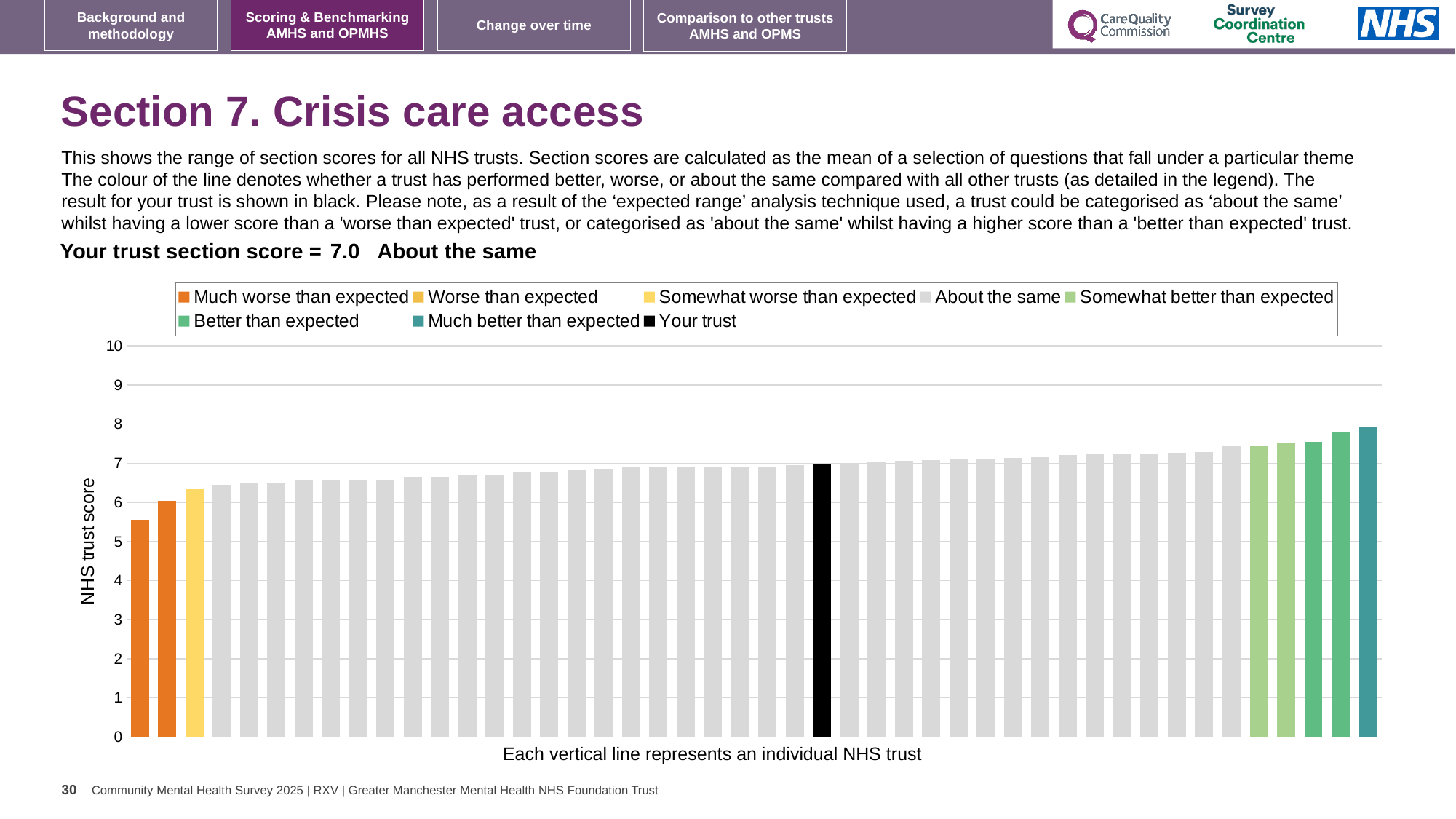
Is the value of the tallest bar greater or less than 7? greater Which legend category does the tallest bar belong to? Much better than expected Which category is your trust placed in for this section? About the same How many entries does the chart legend list? 8 Which legend category does the shortest bar belong to? Much worse than expected What is the label on the vertical axis of the chart? NHS trust score Is the value of the black 'Your trust' bar greater or less than 6? greater What is the section score for your trust, as stated on the slide? 7.0 Do the bar values rise or fall from left to right along the x axis? rise Is the value of the leftmost (lowest) bar greater or less than 6? less How many bars are coloured orange ('Much worse than expected')? 2 What kind of chart is shown on the slide? bar chart